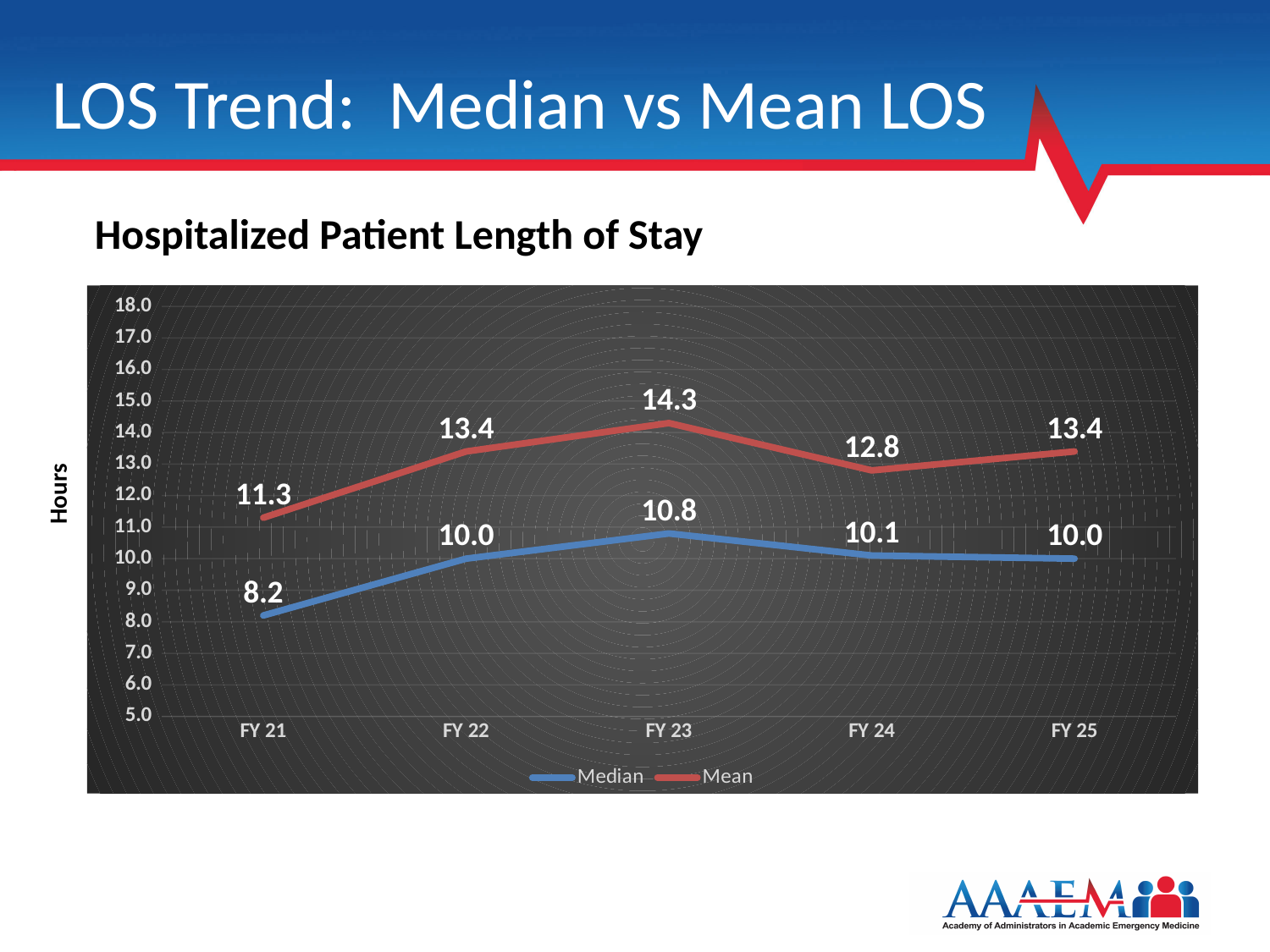
How many fiscal years are plotted on the x axis? 5 What is the difference between the Mean and Median length of stay in FY 23? 3.5 Which is larger, the Mean length of stay in FY 22 or in FY 24? FY 22 What kind of chart is shown on the slide? Line chart What is the Mean length of stay for FY 24? 12.8 What is the Mean length of stay for FY 23? 14.3 What is the label on the vertical axis? Hours What is the difference between the Median length of stay in FY 22 and FY 21? 1.8 What is the Median length of stay for FY 21? 8.2 In which fiscal year is the Median length of stay highest? FY 23 How many series does the legend list? 2 In which fiscal year is the Mean length of stay lowest? FY 21